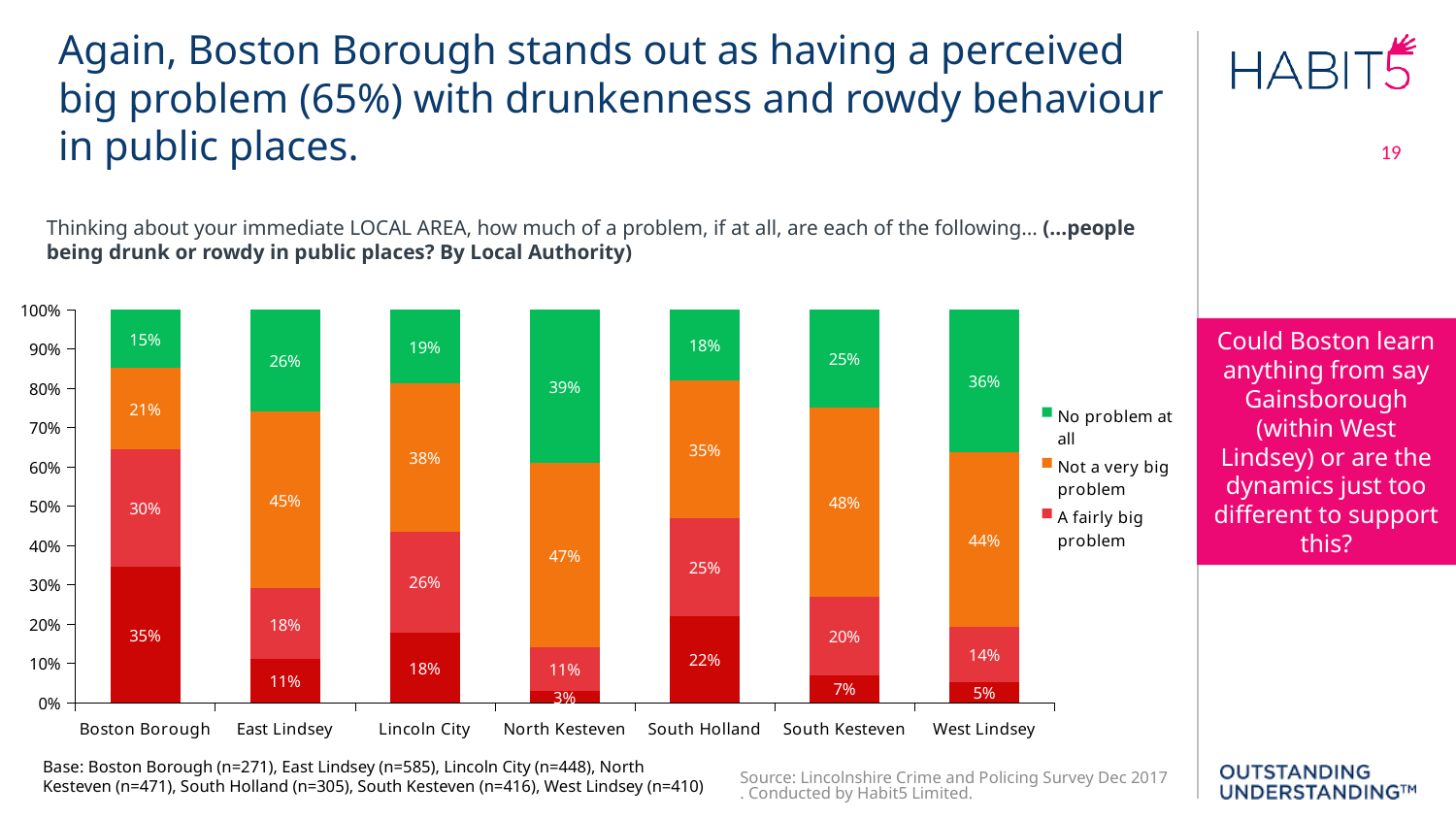
What is the 'Not a very big problem' value for South Kesteven? 48% Which local authority has the highest 'Not a very big problem' percentage? South Kesteven Which local authority has the lowest 'A fairly big problem' percentage? North Kesteven What percentage of North Kesteven respondents said 'No problem at all'? 39% What is the 'No problem at all' value for West Lindsey? 36% How many local authorities are shown on the x axis? 7 Which has a larger 'A fairly big problem' value, Lincoln City or South Kesteven? Lincoln City Which local authority has the highest 'No problem at all' percentage? North Kesteven How many series does the legend list? 3 What is the 'A fairly big problem' value for Boston Borough? 30% What kind of chart is shown on the slide? Stacked bar chart What is the difference in percentage points between the 'Not a very big problem' values for East Lindsey and Boston Borough? 24 percentage points